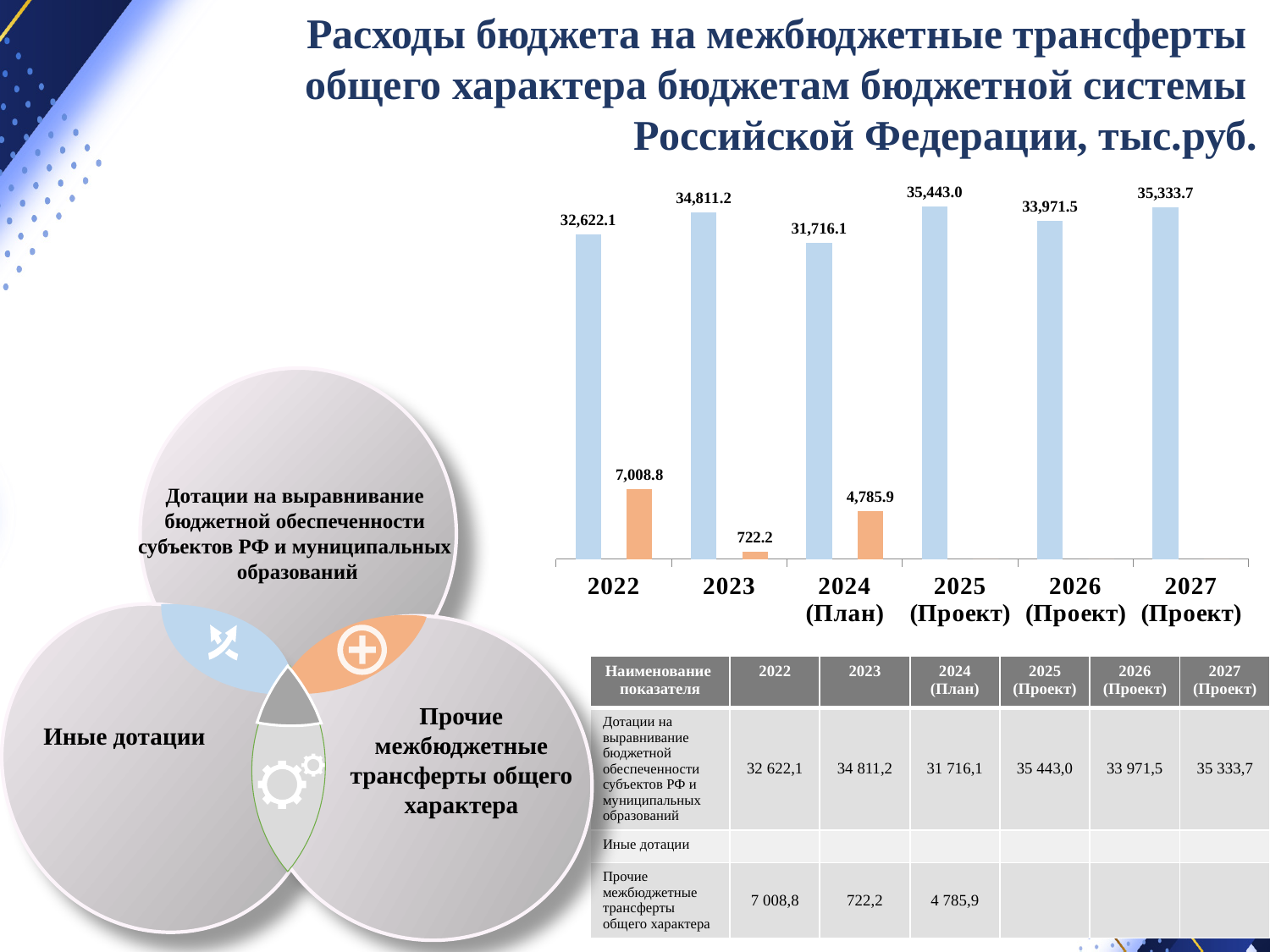
In which year is the orange bar the lowest? 2023 What is the value of the orange bar for 2024 (План)? 4,785.9 What is the value of the blue bar for 2022? 32,622.1 In which year is the blue bar the lowest? 2024 (План) For which years does the chart show an orange bar? 2022, 2023, 2024 (План) What is the difference between the blue bar values for 2025 (Проект) and 2024 (План)? 3,726.9 Which is larger: the blue bar for 2023 or the blue bar for 2026 (Проект)? 2023 What type of chart is shown on the slide? bar chart What is the value of the blue bar for 2025 (Проект)? 35,443.0 What is the value of the orange bar for 2023? 722.2 How many year categories are shown on the x axis of the chart? 6 In which year is the blue bar the highest? 2025 (Проект)